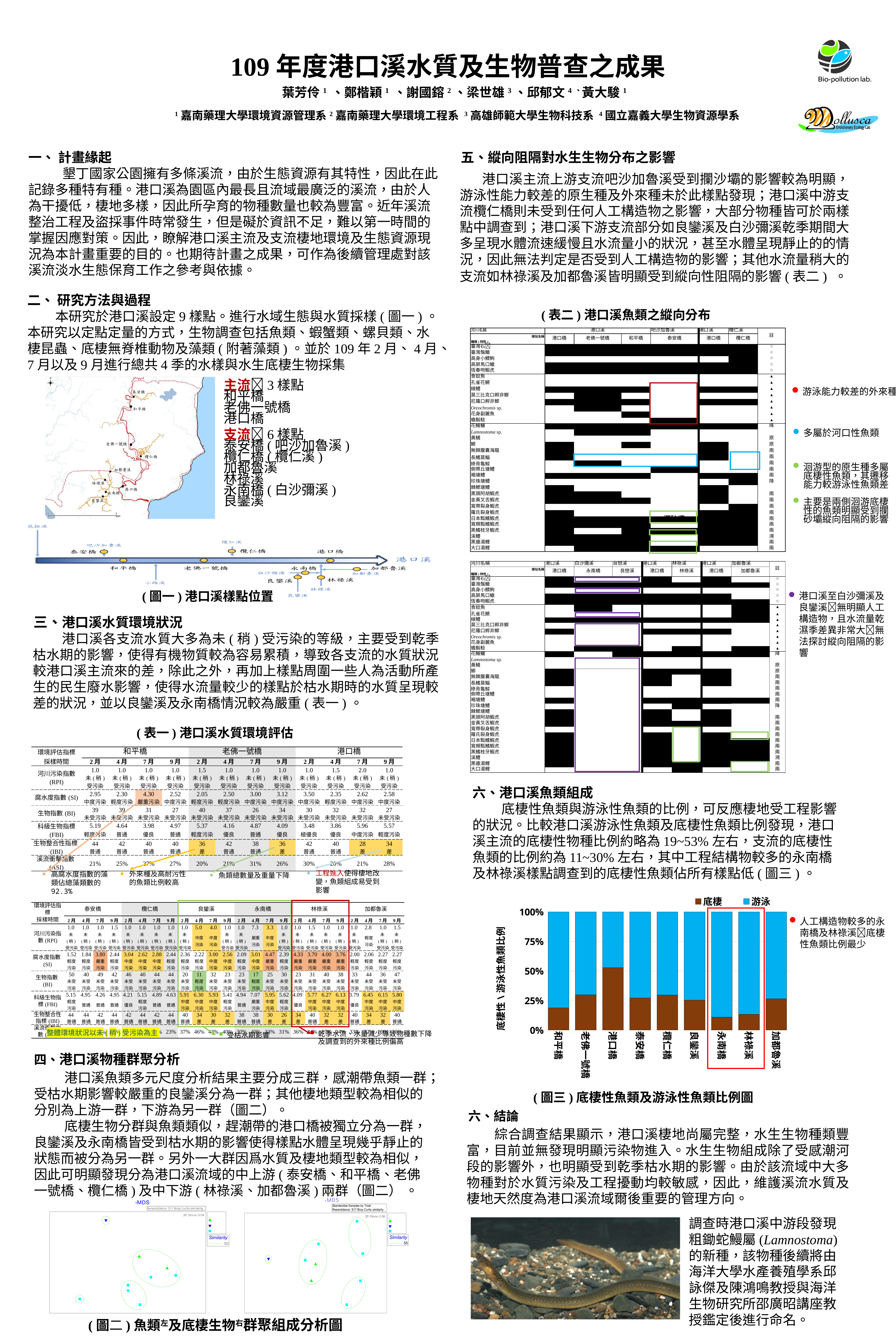
In 圖三, which site has the larger 底棲 proportion, 港口橋 or 和平橋? 港口橋 In 圖三, which two sites are outlined with a red box? 永南橋 and 林祿溪 How many series does the legend of 圖三 list? 2 In 圖三, is the 底棲 proportion for 永南橋 greater or less than 25%? less In 圖三, is the 游泳 proportion for 和平橋 greater or less than 75%? greater In 圖三, what is the total of each stacked bar (底棲 plus 游泳)? 100% In 圖三, which site has the larger 游泳 proportion, 永南橋 or 港口橋? 永南橋 How many sampling sites (categories) are shown on the x axis of 圖三? 9 In 圖三, which site has the highest proportion of 底棲 (benthic) fish? 港口橋 What kind of chart is 圖三 (底棲性魚類及游泳性魚類比例圖)? stacked bar chart In 圖三, which colour represents the 底棲 series? brown In 圖三, is the 底棲 proportion for 港口橋 greater or less than 25%? greater